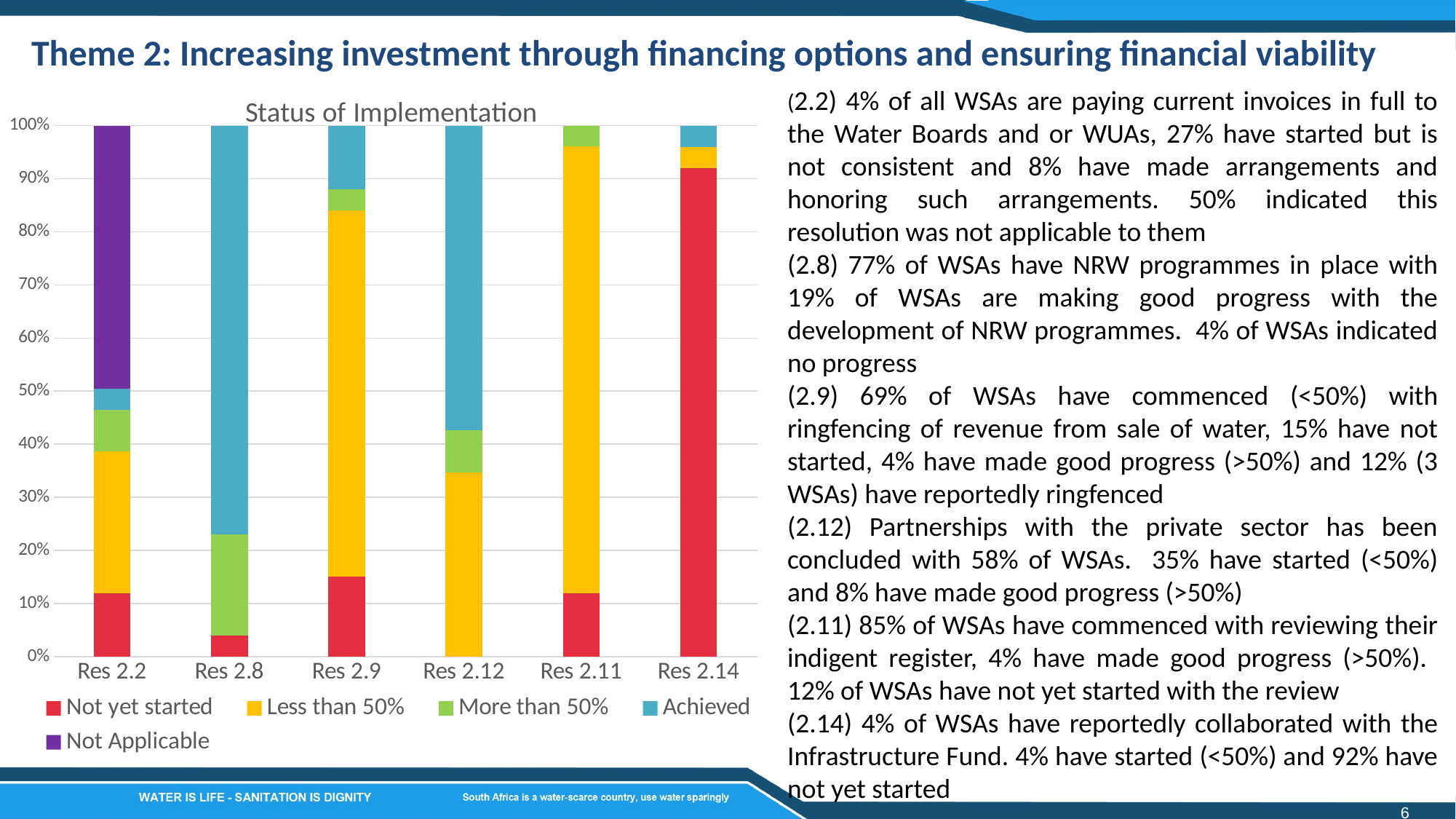
What is the total of the stacked bar for Res 2.2? 100% Is the 'Less than 50%' value for Res 2.11 greater or less than 80%? greater Is the 'Achieved' value for Res 2.8 greater or less than 70%? greater How many series does the chart legend list? 5 Which is larger, the 'Not yet started' value for Res 2.14 or for Res 2.2? Res 2.14 What kind of chart is shown on the slide? Stacked bar chart Is the 'Not yet started' value for Res 2.14 greater or less than 90%? greater What is the title of the chart? Status of Implementation How many categories are shown on the x axis of the chart? 6 Which category has the largest 'Not yet started' segment? Res 2.14 Which category has the largest 'Achieved' segment? Res 2.8